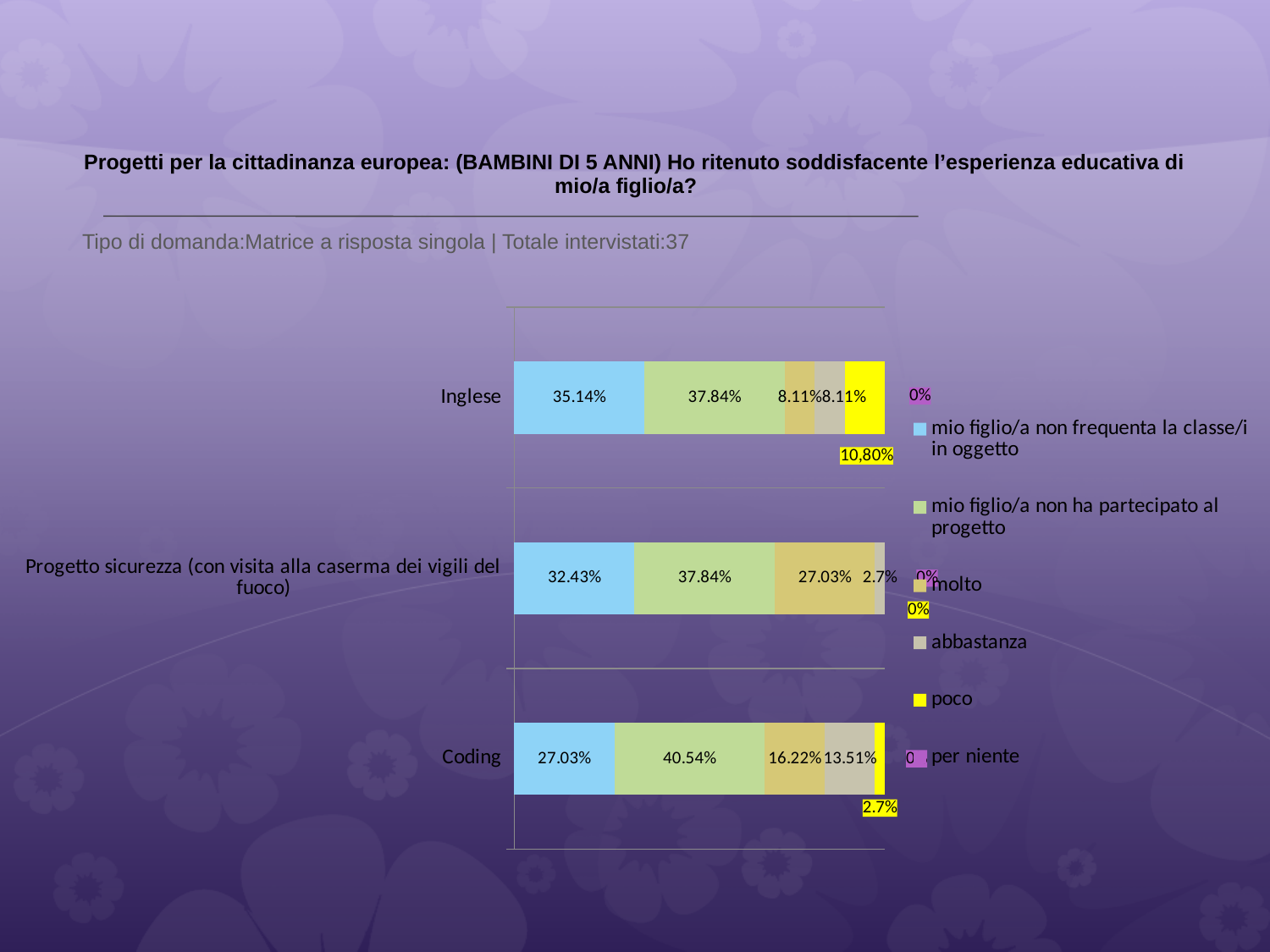
Which category has the lowest value for 'mio figlio/a non frequenta la classe/i in oggetto'? Coding What is the value for 'mio figlio/a non frequenta la classe/i in oggetto' for Inglese? 35.14% How many categories (projects) are plotted on the chart? 3 What is the value for 'molto' for Progetto sicurezza (con visita alla caserma dei vigili del fuoco)? 27.03% What is the value for 'abbastanza' for Coding? 13.51% What is the total number of respondents stated on the slide? 37 How many series does the legend list? 6 Which category has the highest value for 'molto'? Progetto sicurezza (con visita alla caserma dei vigili del fuoco) What is the value for 'mio figlio/a non ha partecipato al progetto' for Coding? 40.54% What is the difference between the 'molto' values for Progetto sicurezza and Coding? 10.81% What kind of chart is shown on the slide? stacked bar chart Which is larger: the 'mio figlio/a non ha partecipato al progetto' value for Coding or for Inglese? Coding